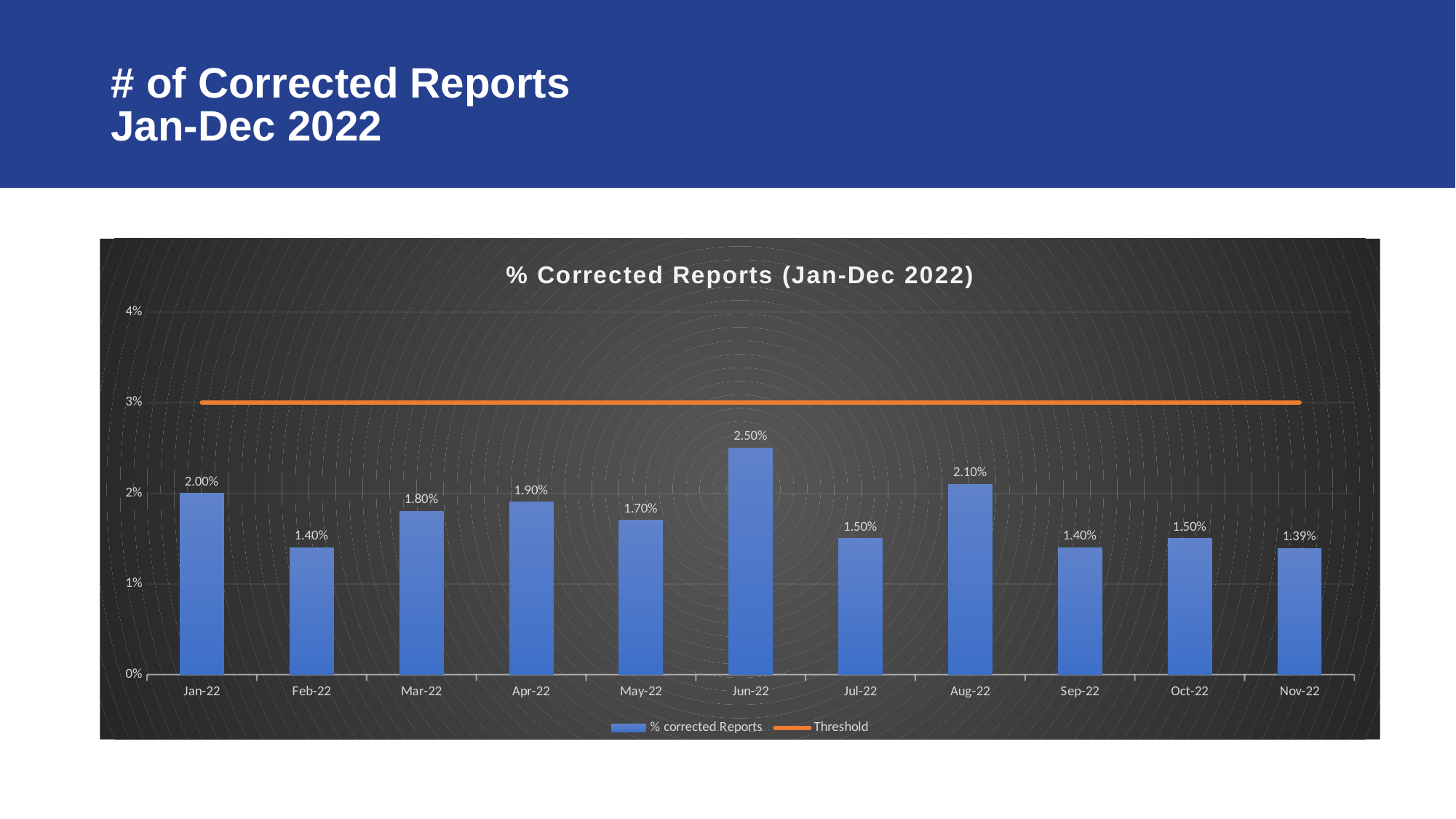
How many series does the legend list? 2 What kind of chart is used to show the % corrected Reports values? Bar chart Is the Threshold line greater or less than 2%? greater Which month has the highest % corrected Reports value? Jun-22 What is the difference between the % corrected Reports values for Jun-22 and Aug-22? 0.40% How many months are shown on the x axis? 11 Which is larger, the % corrected Reports value for Mar-22 or for May-22? Mar-22 What is the % corrected Reports value for Apr-22? 1.90% What is the % corrected Reports value for Jun-22? 2.50% What is the % corrected Reports value for Nov-22? 1.39% What is the title of the chart? % Corrected Reports (Jan-Dec 2022) Which month has the lowest % corrected Reports value? Nov-22